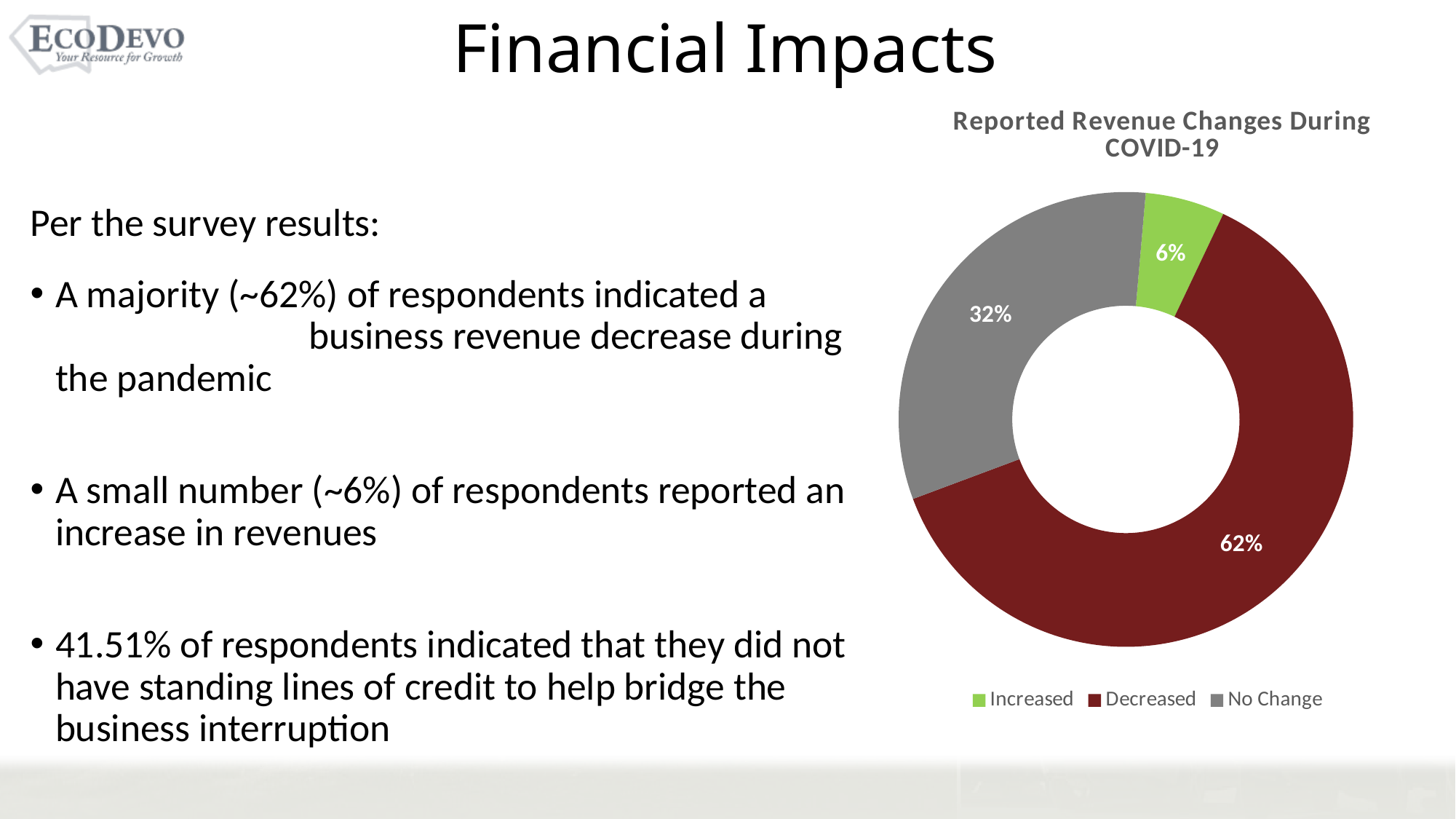
Which category has the largest share of the chart? Decreased What percentage of respondents reported that revenue decreased? 62% What is the title of the chart? Reported Revenue Changes During COVID-19 Which is larger, the share for No Change or the share for Increased? No Change What type of chart is shown on the slide? Doughnut chart What is the difference between the Decreased and No Change shares? 30% Which category has the smallest share of the chart? Increased What percentage of respondents reported that revenue increased? 6% What percentage of respondents reported no change in revenue? 32% Which category is shown in green in the legend? Increased What is the combined share of Increased and No Change? 38% How many categories does the chart show? 3